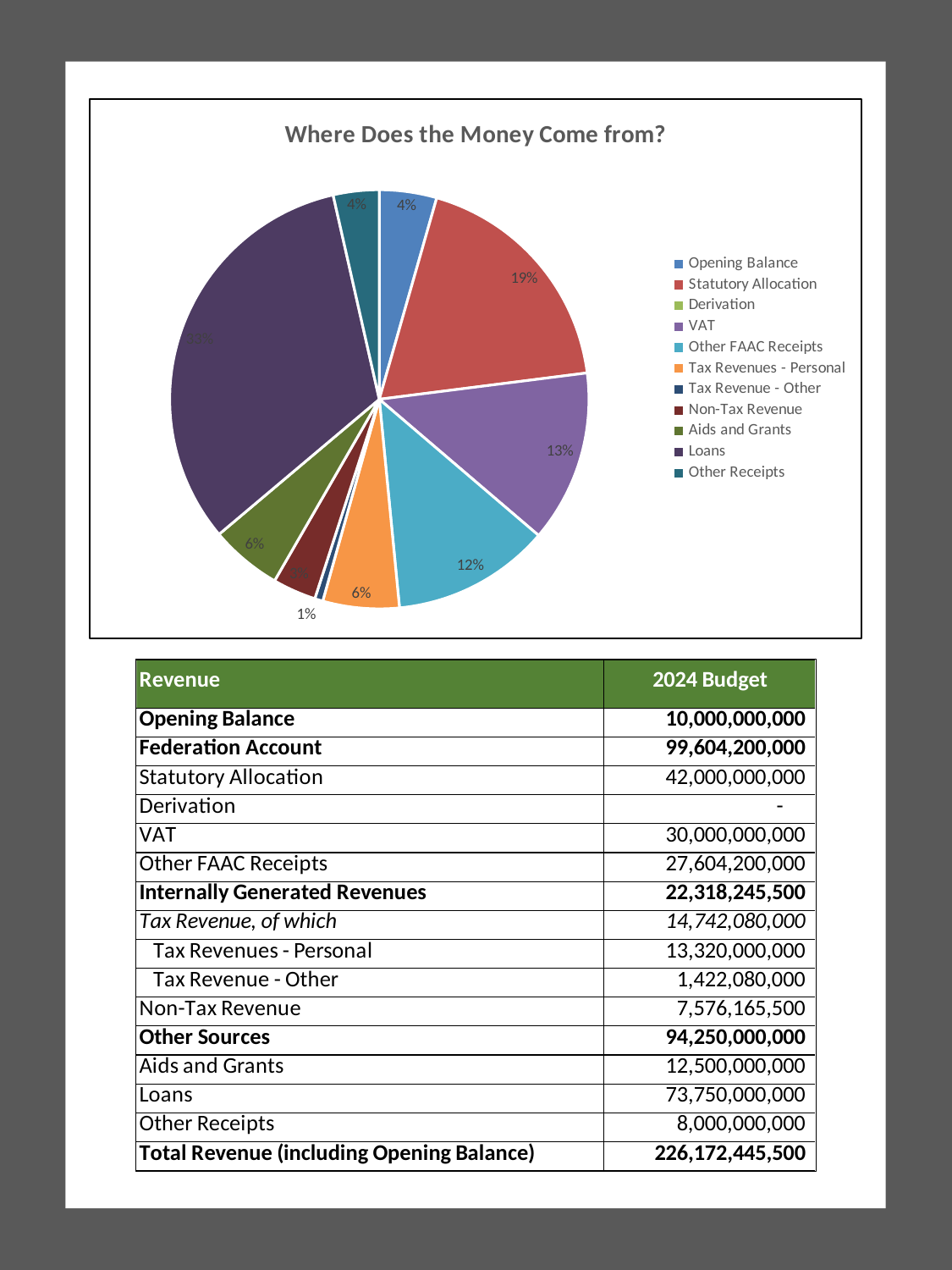
Which is larger, the slice for Statutory Allocation or the slice for VAT? Statutory Allocation By how many percentage points does the Statutory Allocation share exceed the VAT share? 6 percentage points What share of the pie is Statutory Allocation? 19% What share of the pie is Other FAAC Receipts? 12% What kind of chart is shown on the slide? pie chart What share of the pie is Tax Revenues - Personal? 6% Which category has the largest slice of the pie? Loans How many entries does the chart's legend list? 11 What is the title of the chart? Where Does the Money Come from?